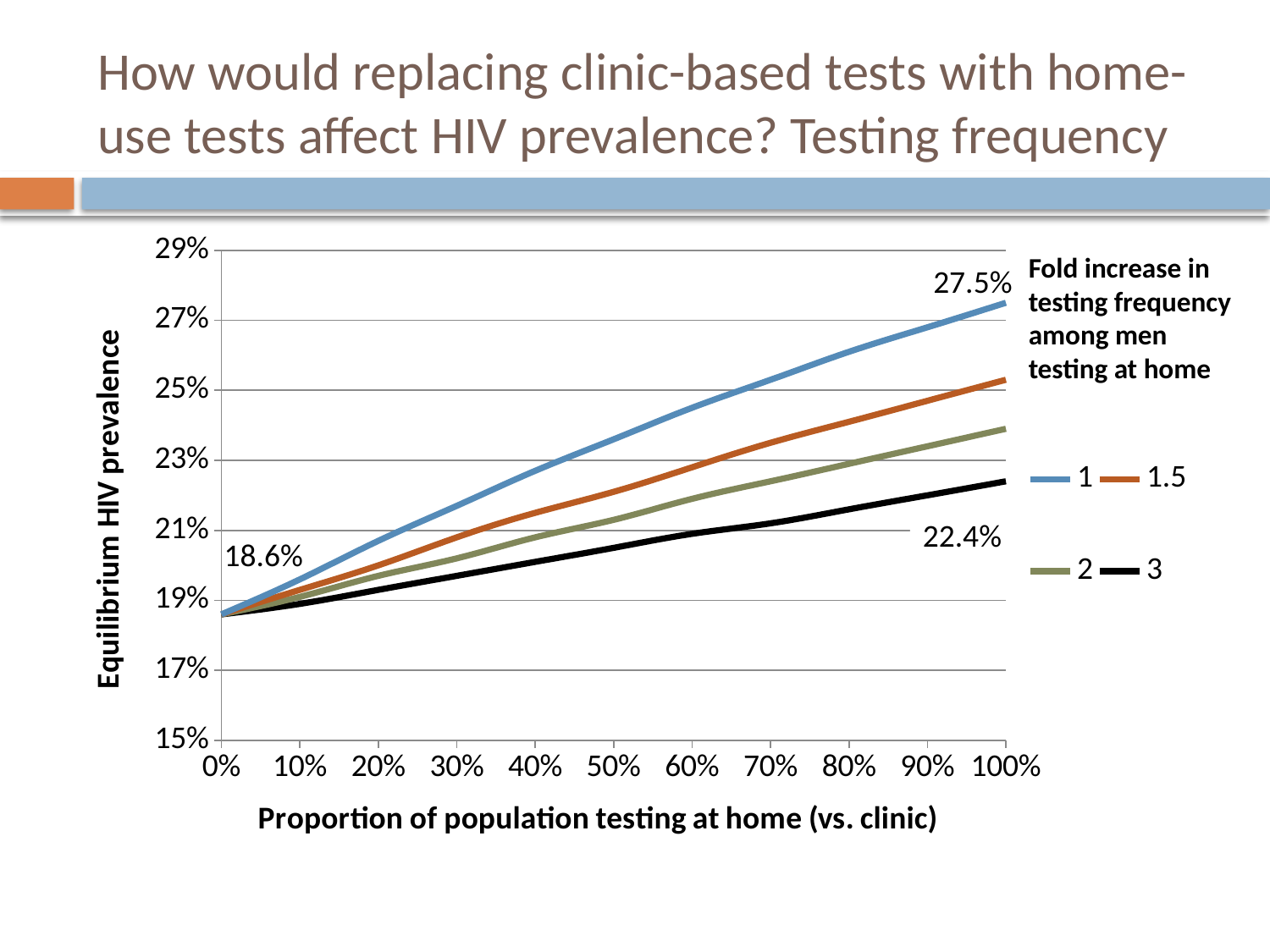
What is the equilibrium HIV prevalence for the series labelled 1 when 100% of the population tests at home? 27.5% Which series has the highest equilibrium HIV prevalence at 100% home testing? 1 Do the equilibrium HIV prevalence values rise or fall as the proportion of the population testing at home increases? Rise Is the equilibrium HIV prevalence for the series labelled 3 at 50% home testing greater or less than 21%? less How many series does the legend list? 4 What is the equilibrium HIV prevalence when 0% of the population tests at home? 18.6% What is the equilibrium HIV prevalence for the series labelled 3 when 100% of the population tests at home? 22.4% What is the difference in equilibrium HIV prevalence at 100% home testing between the series labelled 1 and the series labelled 3? 5.1 percentage points At 100% home testing, which series has the higher equilibrium HIV prevalence: 1.5 or 2? 1.5 What kind of chart is shown on the slide? Line chart By how much does equilibrium HIV prevalence for the series labelled 1 rise from 0% to 100% home testing? 8.9 percentage points Which series has the lowest equilibrium HIV prevalence at 100% home testing? 3